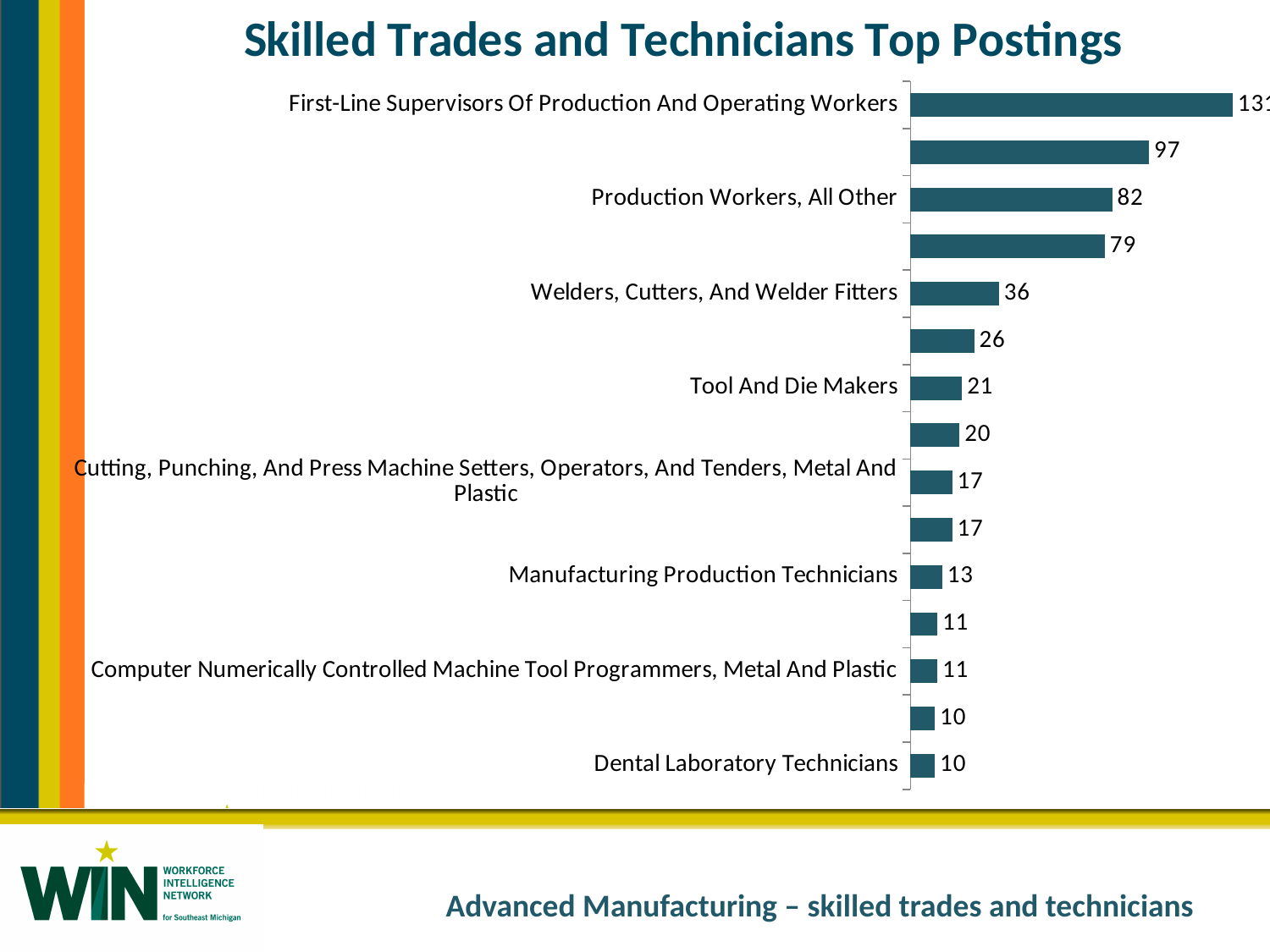
How many bars are plotted in the chart? 15 What is the title of the chart? Skilled Trades and Technicians Top Postings What is the value for Manufacturing Production Technicians? 13 What is the value for Welders, Cutters, And Welder Fitters? 36 What kind of chart is shown on the slide? bar chart What is the difference between the values for Production Workers, All Other and Welders, Cutters, And Welder Fitters? 46 What is the value for Tool And Die Makers? 21 Do the bar values increase or decrease going from the top of the chart to the bottom? decrease What is the value for Production Workers, All Other? 82 Which category has the highest value in the chart? First-Line Supervisors Of Production And Operating Workers What is the value for Dental Laboratory Technicians? 10 Which is larger: the value for Tool And Die Makers or the value for Computer Numerically Controlled Machine Tool Programmers, Metal And Plastic? Tool And Die Makers